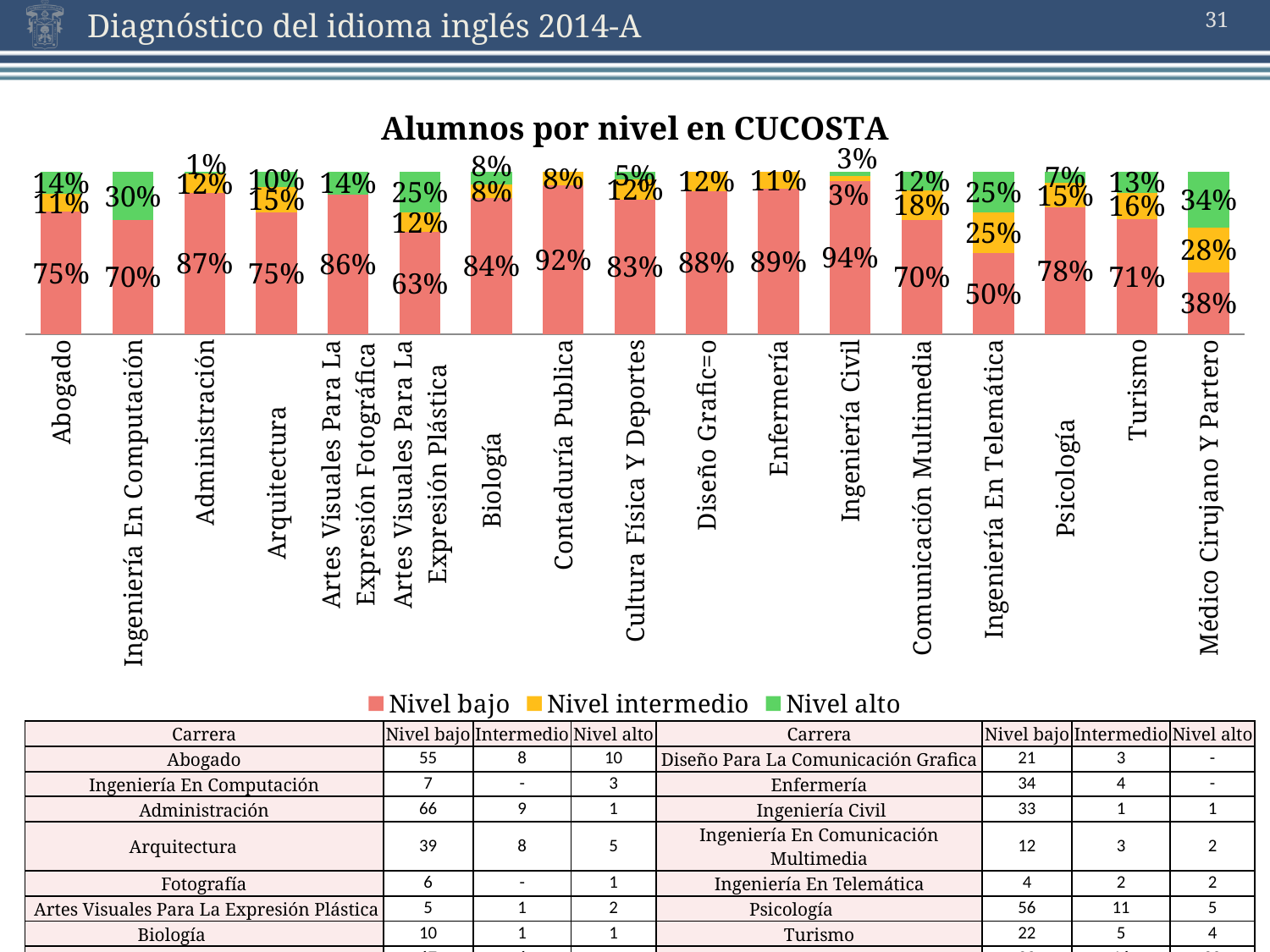
How many series does the chart legend list? 3 What is the Nivel bajo value for Ingeniería Civil? 94% How many categories (carreras) are shown on the x axis of the chart? 17 What is the Nivel alto value for Médico Cirujano Y Partero? 34% Which has a larger Nivel bajo value, Administración or Arquitectura? Administración What is the Nivel intermedio value for Ingeniería En Telemática? 25% Which category has the highest Nivel bajo value? Ingeniería Civil What is the title of the chart? Alumnos por nivel en CUCOSTA What is the difference between the Nivel bajo values for Contaduría Publica and Biología? 8% What is the total of the stacked bar for Médico Cirujano Y Partero? 100% What kind of chart is shown on the slide? Stacked bar chart Which category has the lowest Nivel bajo value? Médico Cirujano Y Partero